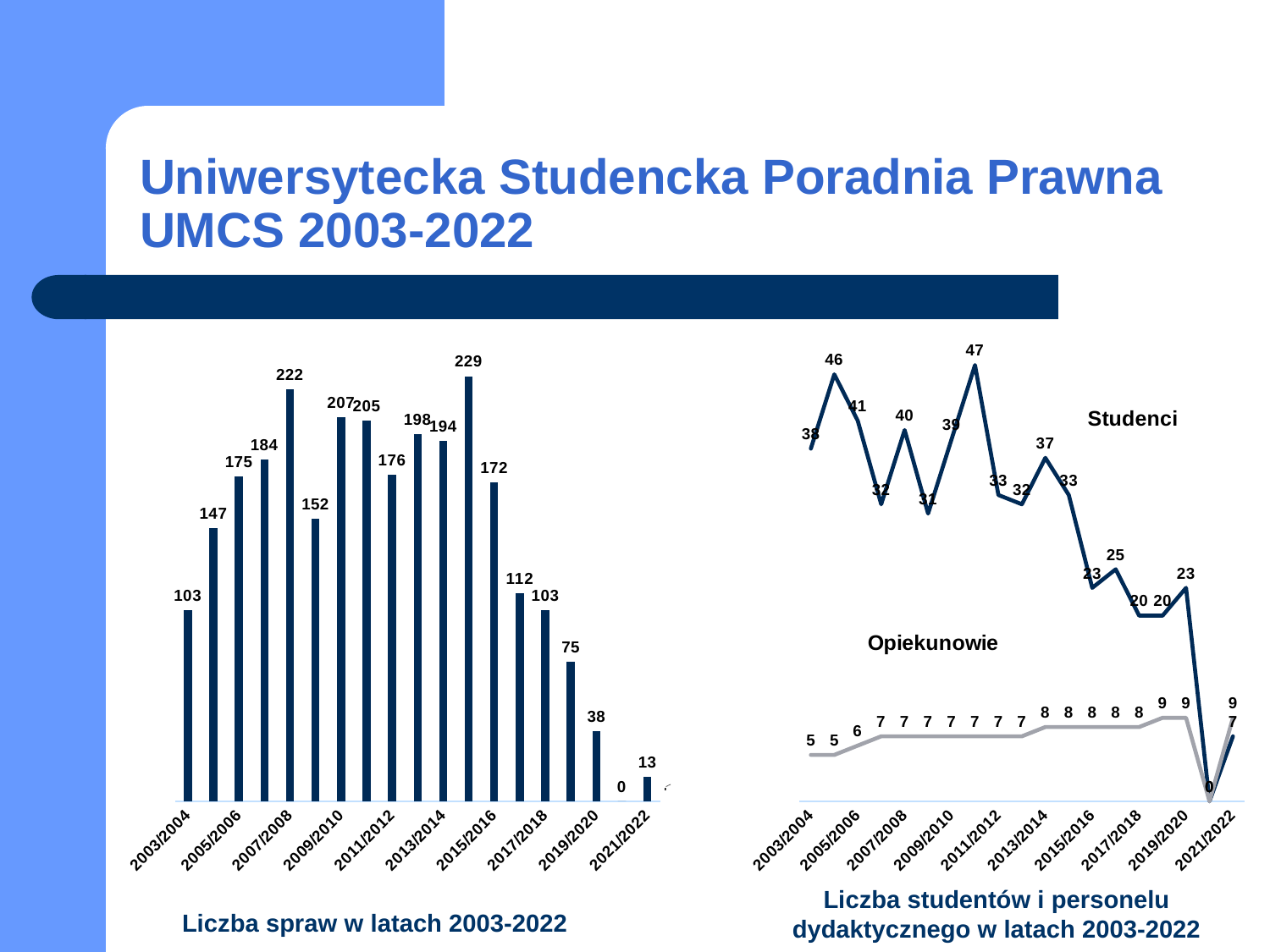
On the left chart (Liczba spraw w latach 2003-2022), how many bars are plotted? 19 On the right chart (Liczba studentów i personelu dydaktycznego), what is the Opiekunowie value for 2021/2022? 9 On the left chart (Liczba spraw w latach 2003-2022), what is the highest value shown? 229 On the left chart (Liczba spraw w latach 2003-2022), what is the value for 2021/2022? 13 On the left chart (Liczba spraw w latach 2003-2022), what is the lowest value shown? 0 On the left chart (Liczba spraw w latach 2003-2022), what is the value for 2007/2008? 222 On the right chart (Liczba studentów i personelu dydaktycznego), what is the highest Studenci value? 47 On the left chart (Liczba spraw w latach 2003-2022), what is the difference between the values for 2007/2008 and 2021/2022? 209 How many series are plotted on the right chart (Liczba studentów i personelu dydaktycznego)? 2 On the right chart (Liczba studentów i personelu dydaktycznego), what is the Studenci value for 2003/2004? 38 On the left chart (Liczba spraw w latach 2003-2022), which is larger, the value for 2009/2010 or the value for 2011/2012? 2009/2010 What kind of chart is the left chart (Liczba spraw w latach 2003-2022)? bar chart